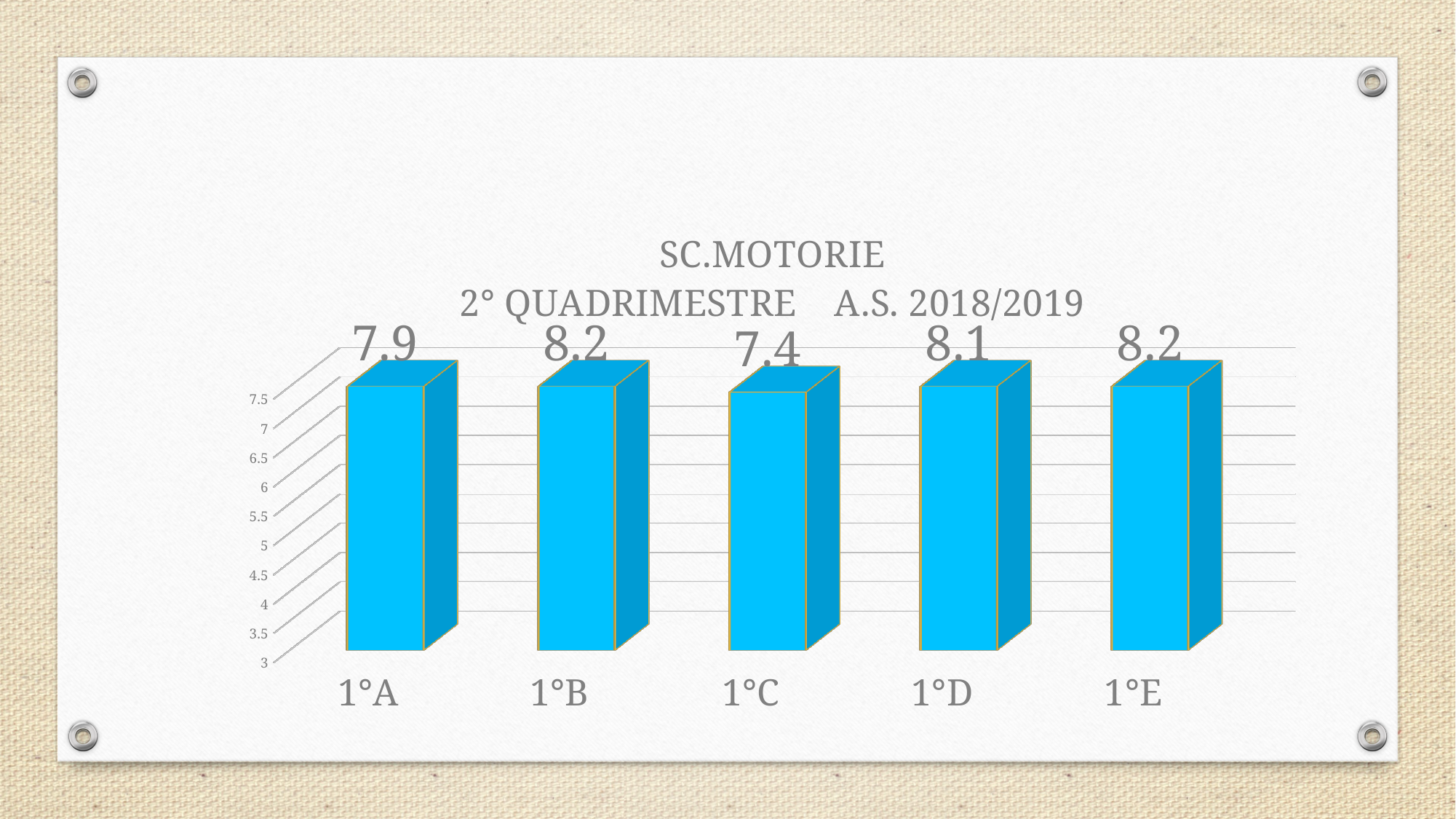
What is the difference between the values for 1°D and 1°A? 0.2 What is the title of the chart? SC.MOTORIE 2° QUADRIMESTRE A.S. 2018/2019 What is the difference between the values for 1°B and 1°C? 0.8 How many classes are shown on the x axis? 5 Which is larger, the value for 1°D or the value for 1°E? 1°E What is the value for 1°A? 7.9 What colour are the bars in the chart? blue What is the value for 1°D? 8.1 Which class has the lowest value? 1°C What is the value for 1°C? 7.4 What kind of chart is shown on the slide? bar chart Which is larger, the value for 1°A or the value for 1°C? 1°A